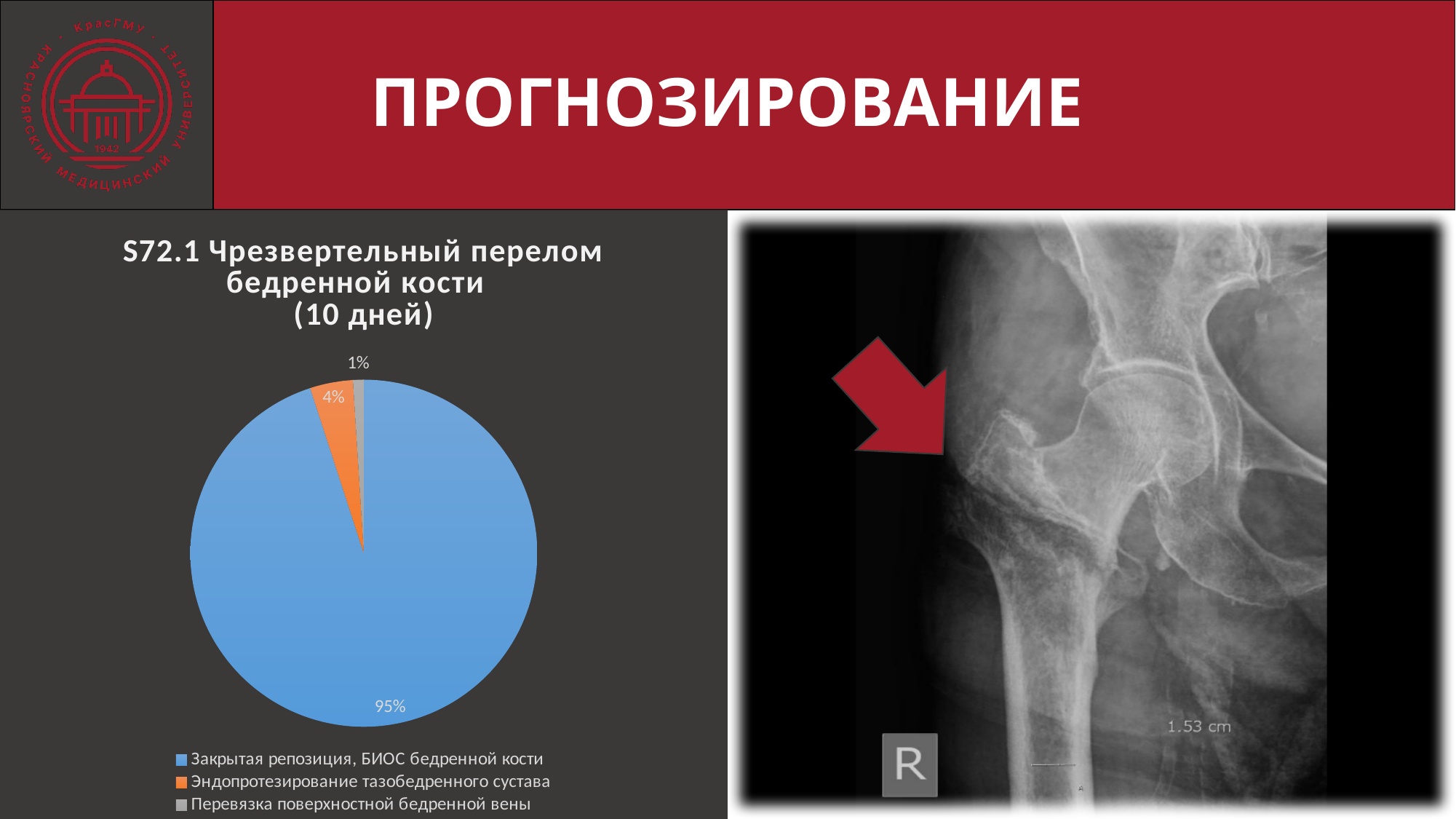
What share of the pie does "Эндопротезирование тазобедренного сустава" have? 4% How many categories does the pie chart have? 3 Which category has the largest slice of the pie? Закрытая репозиция, БИОС бедренной кости What share of the pie does "Закрытая репозиция, БИОС бедренной кости" have? 95% What kind of chart is shown on the slide? pie chart What is the title of the pie chart? S72.1 Чрезвертельный перелом бедренной кости (10 дней) What colour is the slice for "Эндопротезирование тазобедренного сустава"? orange Which is larger: the slice for "Эндопротезирование тазобедренного сустава" or the slice for "Перевязка поверхностной бедренной вены"? Эндопротезирование тазобедренного сустава Which category has the smallest slice of the pie? Перевязка поверхностной бедренной вены What is the difference in percentage points between "Закрытая репозиция, БИОС бедренной кости" and "Эндопротезирование тазобедренного сустава"? 91 What share of the pie does "Перевязка поверхностной бедренной вены" have? 1%